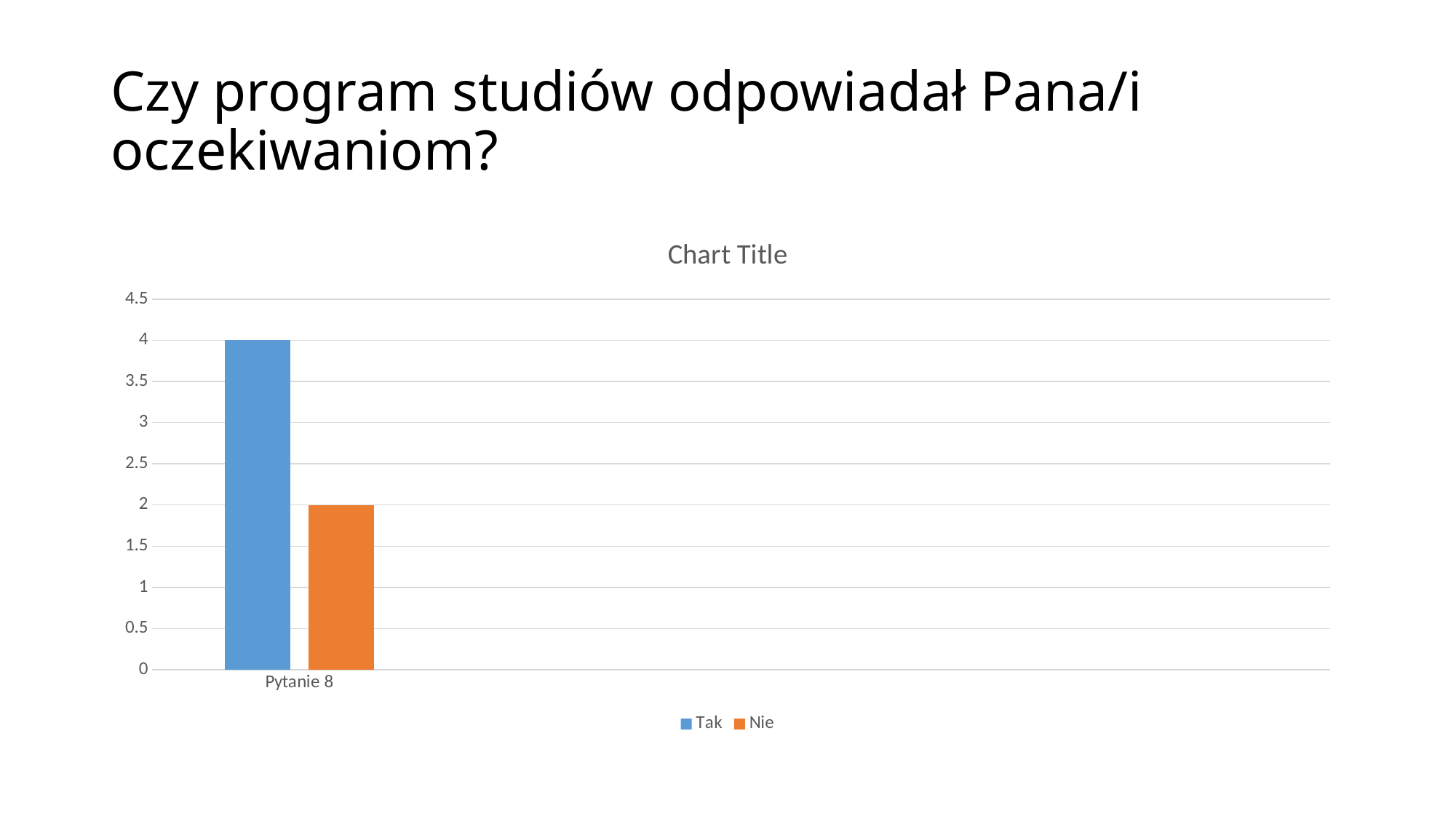
Which series has the lowest value for Pytanie 8? Nie What is the value for Tak for Pytanie 8? 4 What is the value for Nie for Pytanie 8? 2 How many categories are shown on the x axis? 1 Is the value for Nie greater or less than 3? less Which series has the higher value for Pytanie 8, Tak or Nie? Tak Is the value for Tak greater or less than 3? greater How many series does the legend list? 2 What kind of chart is shown on the slide? bar chart What is the title shown above the chart? Chart Title What is the difference between the Tak and Nie values for Pytanie 8? 2 What colour is the bar for the Nie series? orange